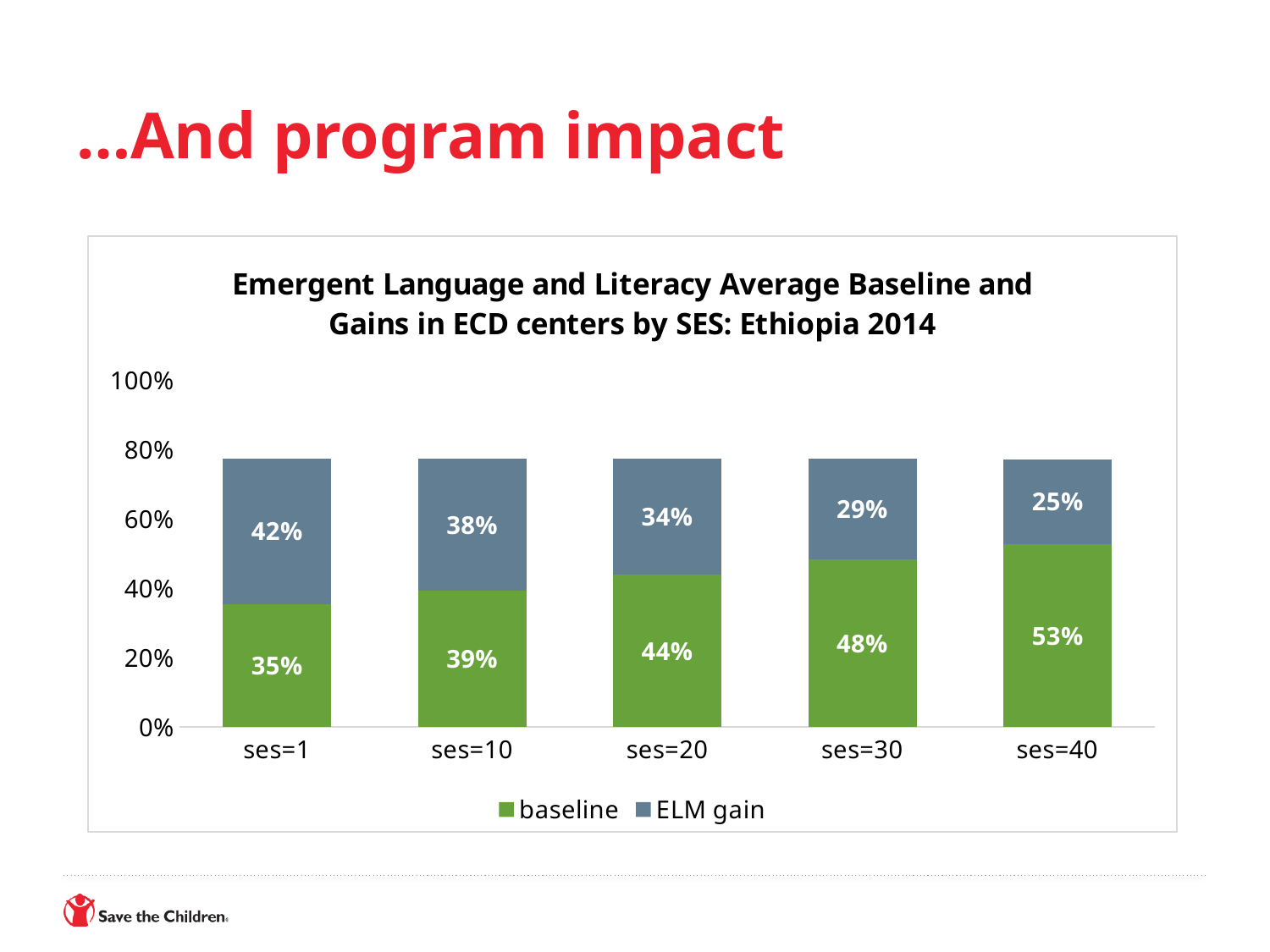
What is the total of the stacked bar for ses=30? 77% What is the ELM gain value for ses=1? 42% How many SES categories are shown on the x axis? 5 What is the ELM gain value for ses=40? 25% What is the difference between the baseline values for ses=40 and ses=1? 18% What kind of chart is shown on the slide? Stacked bar chart Do the baseline values rise or fall as SES increases along the x axis? Rise Which is larger, the ELM gain for ses=10 or the ELM gain for ses=30? ses=10 What is the baseline value for ses=20? 44% Which SES category has the highest baseline value? ses=40 Which SES category has the lowest ELM gain value? ses=40 How many series does the legend list? 2